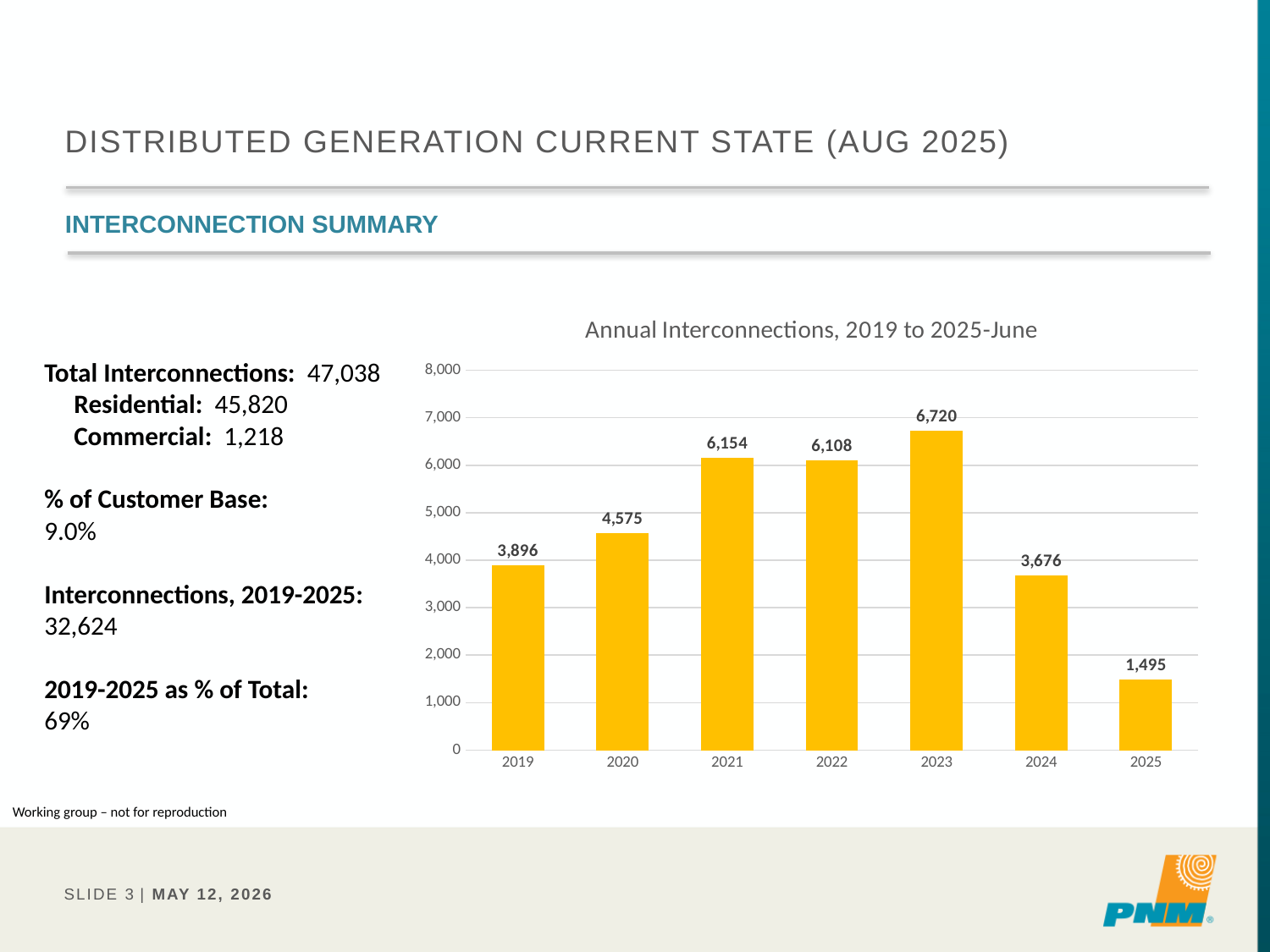
Which year has the lowest value in the Annual Interconnections chart? 2025 Which is larger in the Annual Interconnections chart, the value for 2021 or the value for 2022? 2021 What kind of chart is the Annual Interconnections chart? bar chart How many years are shown on the x axis of the Annual Interconnections chart? 7 Which year has the highest value in the Annual Interconnections chart? 2023 What is the difference between the values for 2023 and 2022 in the Annual Interconnections chart? 612 What is the value for 2021 in the Annual Interconnections chart? 6,154 What is the title of the chart on the slide? Annual Interconnections, 2019 to 2025-June What is the value for 2024 in the Annual Interconnections chart? 3,676 What is the difference between the values for 2020 and 2019 in the Annual Interconnections chart? 679 What is the value for 2019 in the Annual Interconnections chart? 3,896 Is the value for 2024 in the Annual Interconnections chart greater or less than 4,000? less